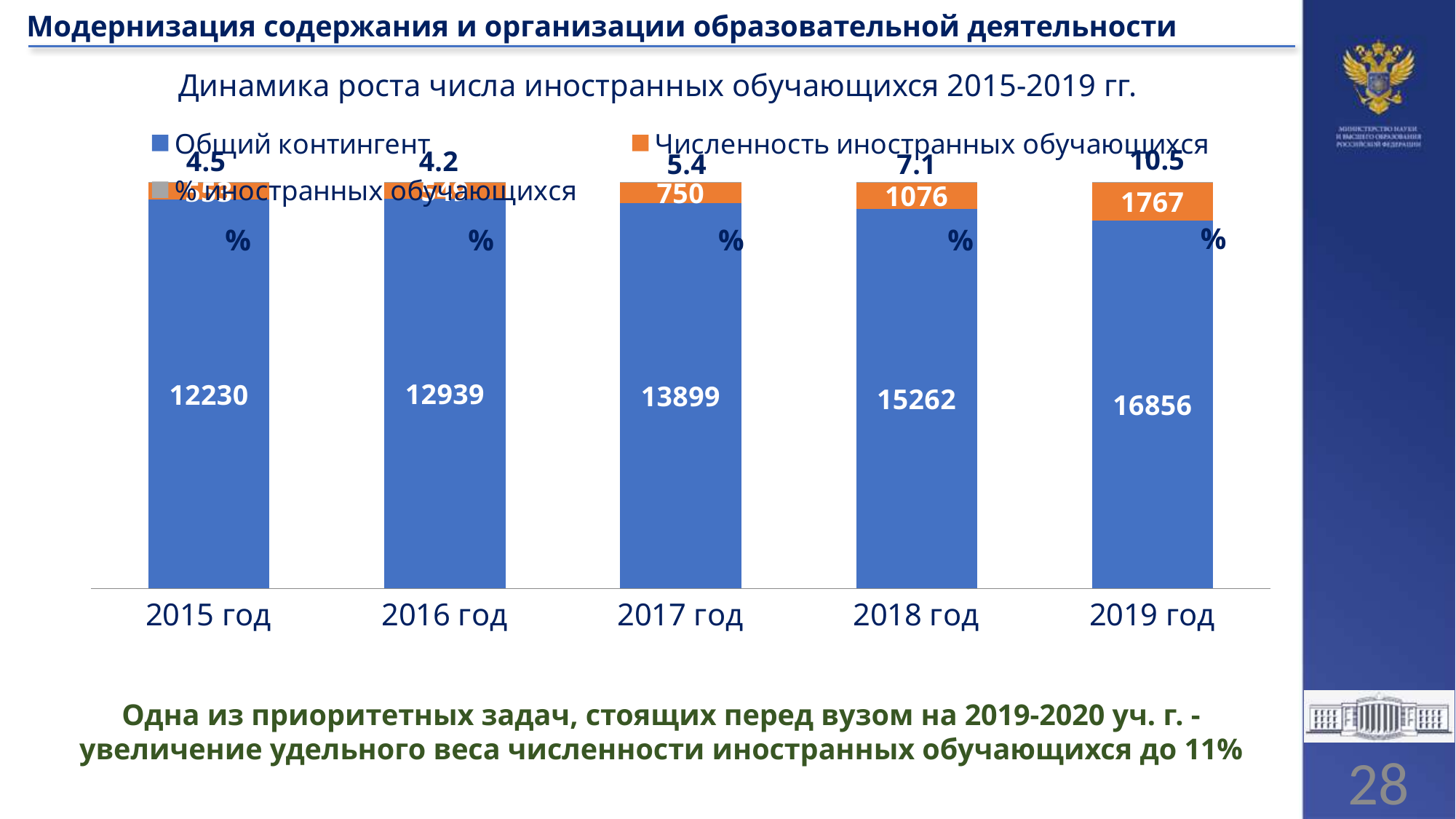
What is the difference in Общий контингент between 2019 год and 2018 год? 1594 What is the difference in Численность иностранных обучающихся between 2019 год and 2017 год? 1017 What is the value of Численность иностранных обучающихся for 2018 год? 1076 What is the value of Общий контингент for 2015 год? 12230 What is the value of Численность иностранных обучающихся for 2017 год? 750 Which year has the highest value of Общий контингент? 2019 год How many series does the chart legend list? 3 Which year has a larger Общий контингент, 2016 год or 2017 год? 2017 год How many years are shown on the x axis of the chart? 5 What is the value of Общий контингент for 2019 год? 16856 Which year has the lowest value of Общий контингент? 2015 год What kind of chart is shown on the slide? Stacked bar chart